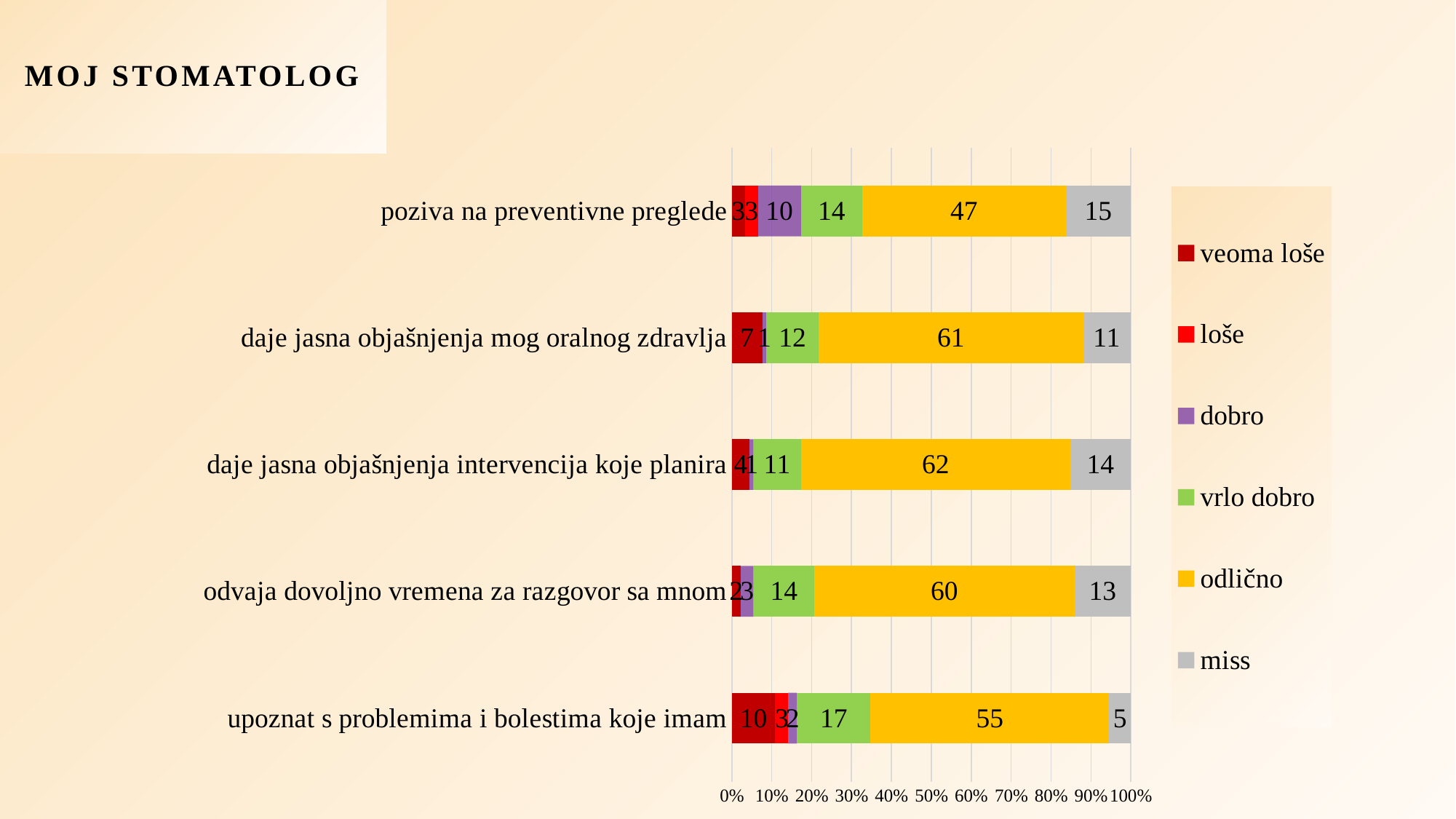
What is the value of the "odlično" segment for "daje jasna objašnjenja intervencija koje planira"? 62 What type of chart is shown on the slide? Stacked bar chart How many categories (bars) are shown in the chart? 5 What is the value of the "miss" segment for "poziva na preventivne preglede"? 15 Which has the larger "vrlo dobro" value: "upoznat s problemima i bolestima koje imam" or "poziva na preventivne preglede"? upoznat s problemima i bolestima koje imam How many series does the legend list? 6 Which category has the highest "odlično" value? daje jasna objašnjenja intervencija koje planira What is the value of the "odlično" segment for "poziva na preventivne preglede"? 47 What is the title of the slide? MOJ STOMATOLOG Which category has the lowest "miss" value? upoznat s problemima i bolestima koje imam What is the value of the "vrlo dobro" segment for "upoznat s problemima i bolestima koje imam"? 17 What is the difference between the "odlično" values for "odvaja dovoljno vremena za razgovor sa mnom" and "poziva na preventivne preglede"? 13